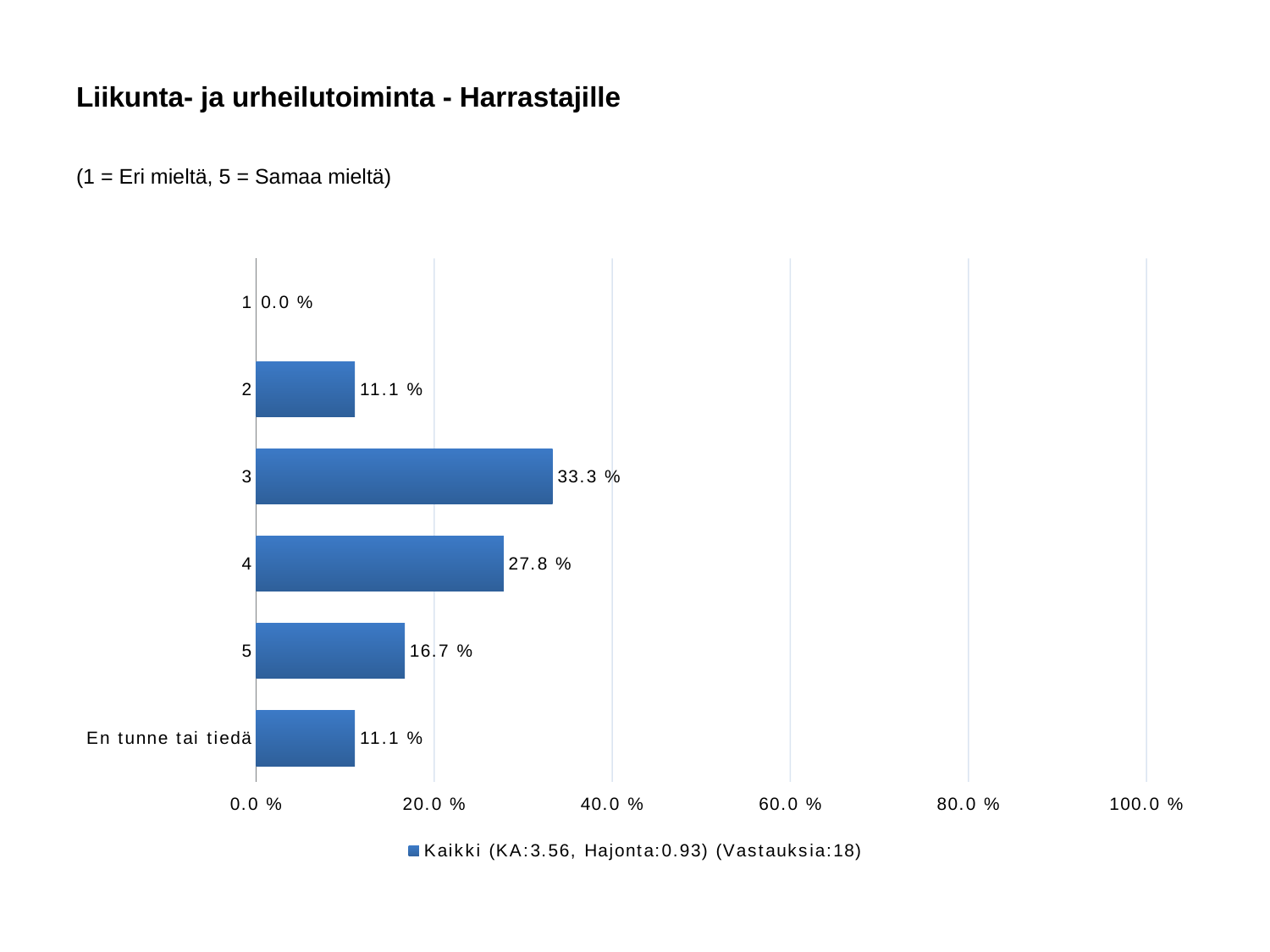
What kind of chart is shown on the slide? bar chart How many series does the legend list? 1 Is the value for category 3 greater or less than 40.0 %? less What is the value for category 3? 33.3 % Which category has the lowest value? 1 Which category has the highest value? 3 What is the difference between the values for category 3 and category 4? 5.5 % Which is larger, the value for category 4 or the value for category 5? 4 What is the legend entry for the series? Kaikki (KA:3.56, Hajonta:0.93) (Vastauksia:18) What is the value for 'En tunne tai tiedä'? 11.1 % How many categories are shown on the chart? 6 What is the value for category 5? 16.7 %